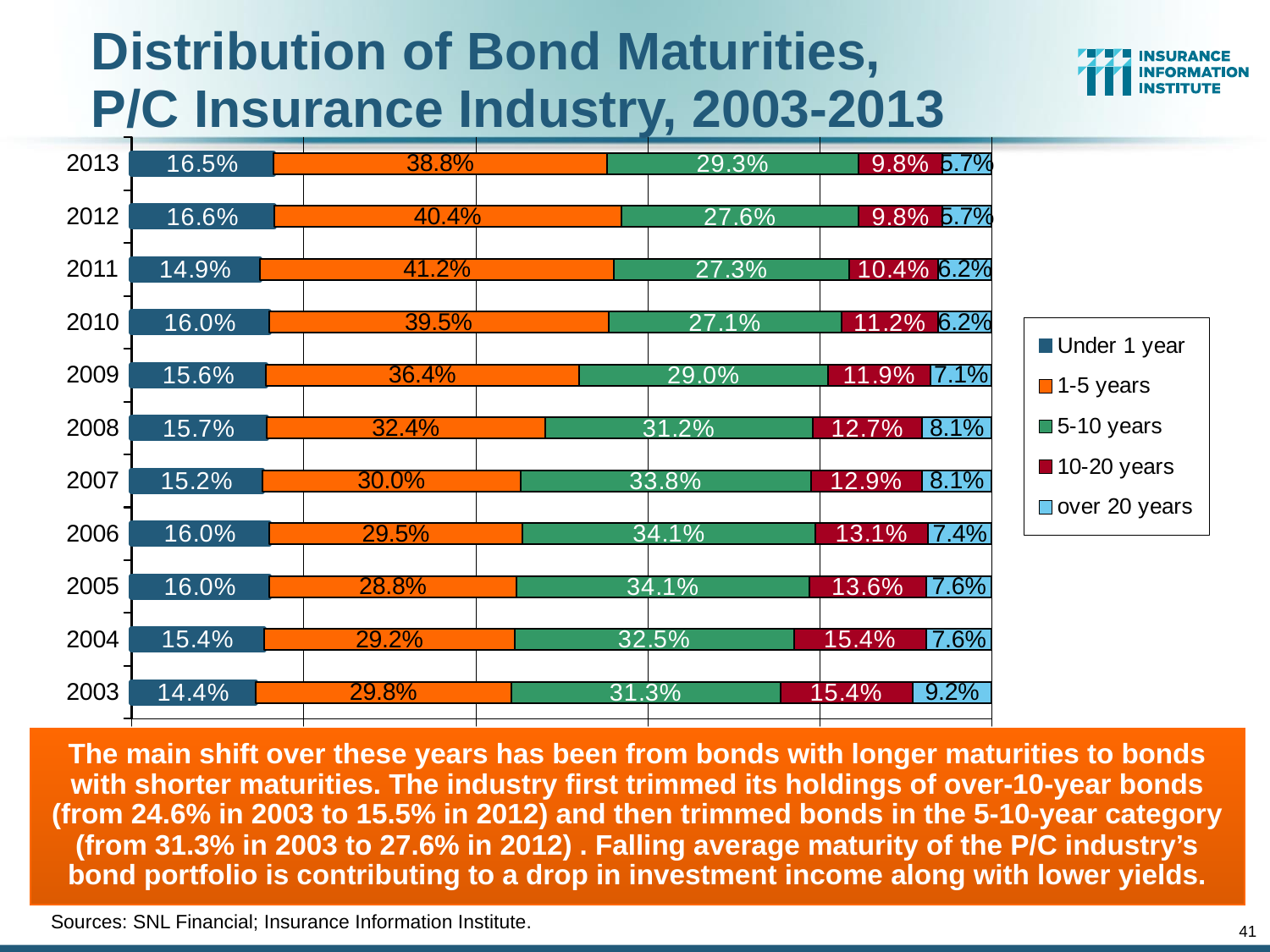
How many series does the legend list? 5 What type of chart is shown on the slide? Stacked bar chart What share of bonds had maturities of 1-5 years in 2011? 41.2% In which year was the 1-5 years share the highest? 2011 What is the difference between the 10-20 years share in 2003 and in 2013? 5.6 percentage points What colour represents the 1-5 years series in the legend? Orange Which was larger in 2007: the 1-5 years share or the 5-10 years share? 5-10 years How did the 10-20 years share change from 2003 to 2013? It fell What was the 5-10 years share in 2003? 31.3% In which year was the Under 1 year share the lowest? 2003 How many years are shown on the chart? 11 What was the over 20 years share in 2008? 8.1%